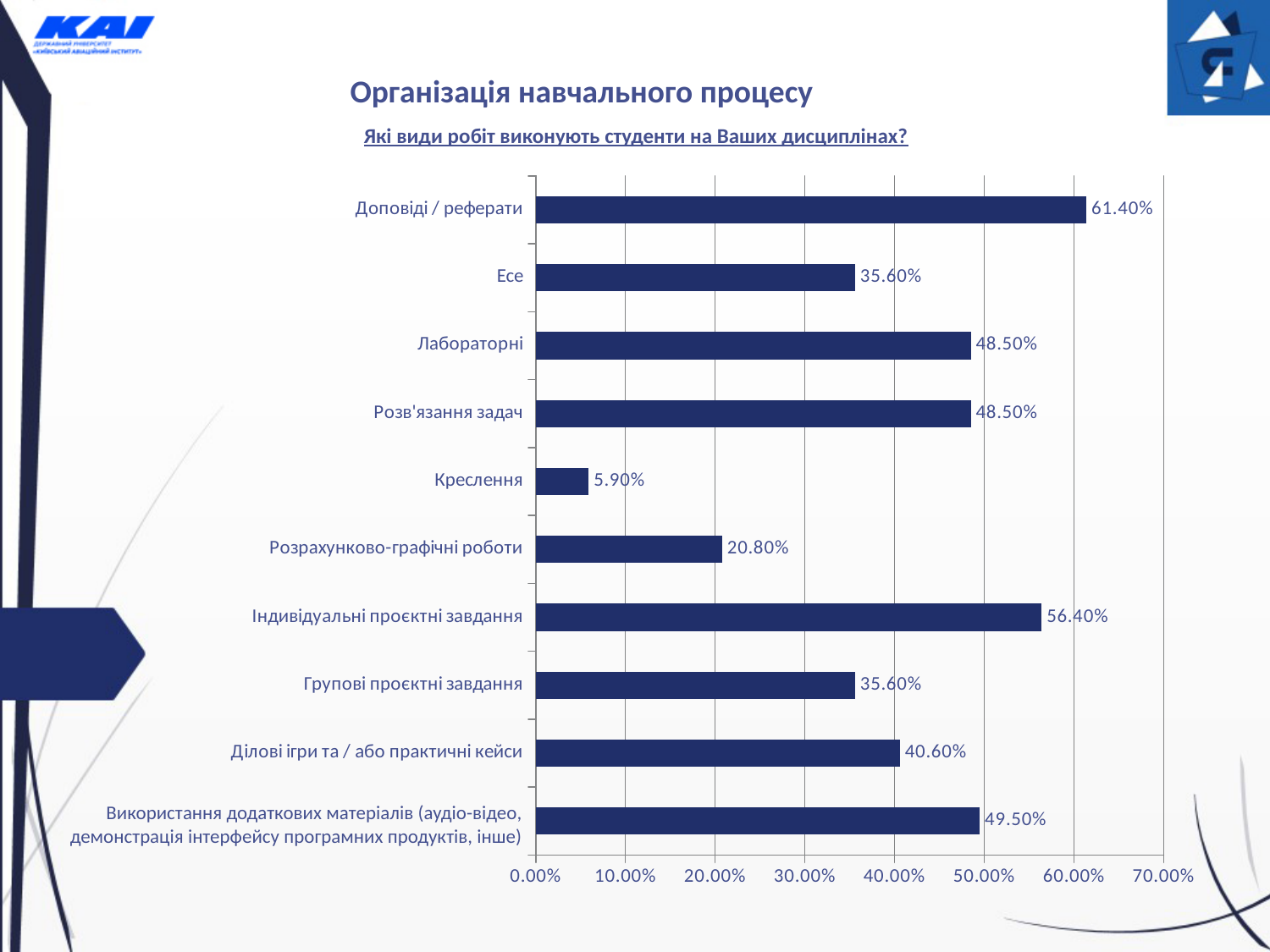
What is the value for Креслення? 5.90% What kind of chart is shown on the slide? bar chart Which category has the lowest value? Креслення What question is the chart titled with? Які види робіт виконують студенти на Ваших дисциплінах? Which category has the highest value? Доповіді / реферати Which is larger, the value for Есе or the value for Лабораторні? Лабораторні What is the value for Доповіді / реферати? 61.40% What is the value for Використання додаткових матеріалів (аудіо-відео, демонстрація інтерфейсу програмних продуктів, інше)? 49.50% How many categories are shown in the chart? 10 Is the value for Розрахунково-графічні роботи greater or less than 30.00%? less What is the difference between the values for Доповіді / реферати and Індивідуальні проєктні завдання? 5.00% What is the value for Ділові ігри та / або практичні кейси? 40.60%